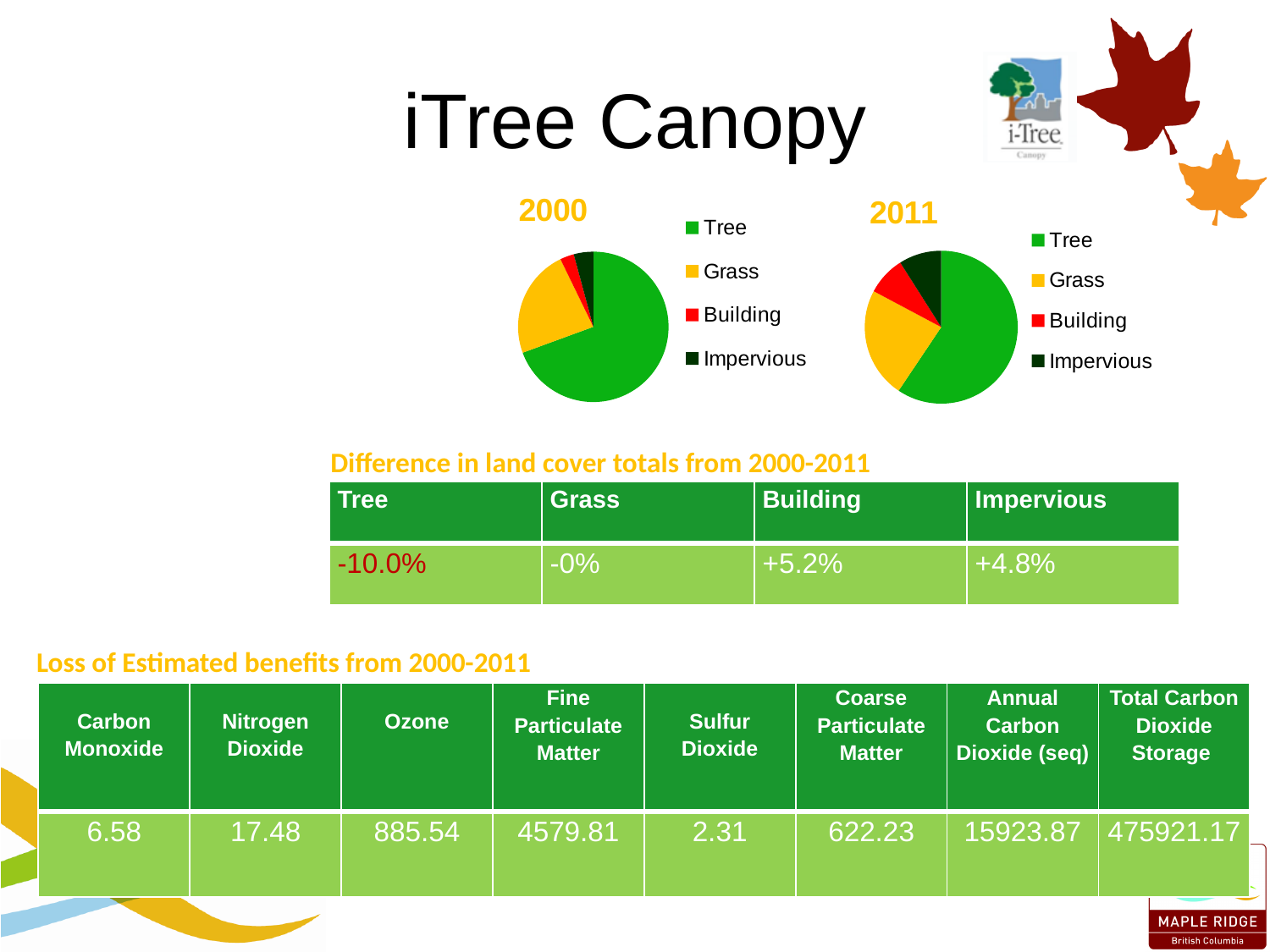
In the 2000 pie chart, which category has the largest slice? Tree In the 2011 pie chart, which slice is larger, Grass or Impervious? Grass What kind of chart is the 2011 chart? pie chart In the 2011 pie chart, which slice is larger, Tree or Grass? Tree How many categories does the legend of the 2000 pie chart list? 4 How many slices does the 2011 pie chart have? 4 What are the titles of the two pie charts on the slide? 2000 and 2011 What colour represents Building in the pie chart legends? red In the 2011 pie chart, which category has the largest slice? Tree In the 2000 pie chart, which slice is larger, Grass or Building? Grass What kind of chart is the 2000 chart? pie chart